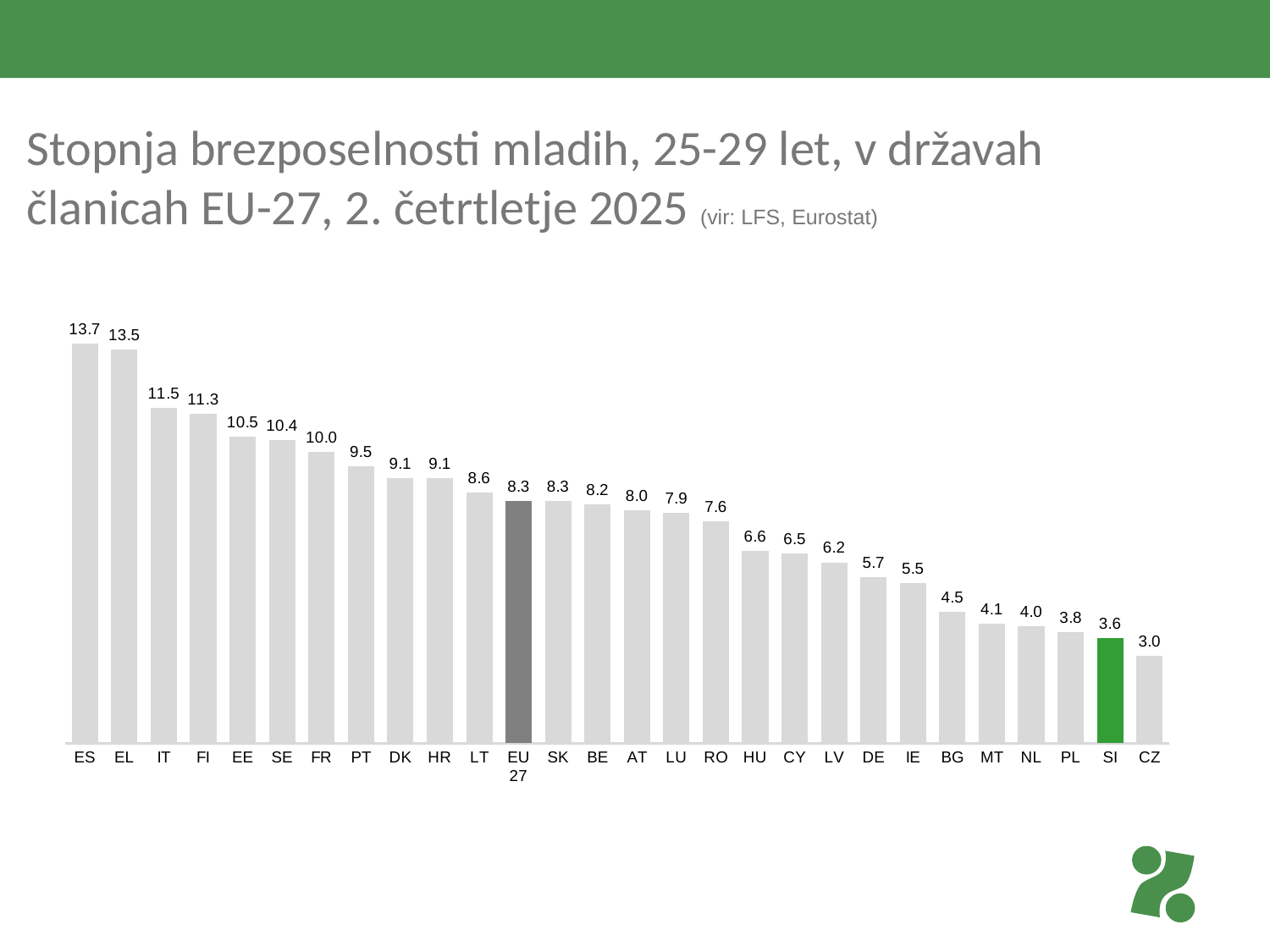
What is the value for EU 27? 8.3 How many bars are shown in the chart? 28 What is the value for SI? 3.6 Which bar is coloured green? SI Which is larger, the value for IT or the value for FR? IT What kind of chart is this? bar chart Which category has the lowest value? CZ What is the value for DE? 5.7 Do the values rise or fall from left to right along the x axis? fall What is the difference between the values for EU 27 and SI? 4.7 Which category has the highest value? ES What is the difference between the values for ES and CZ? 10.7